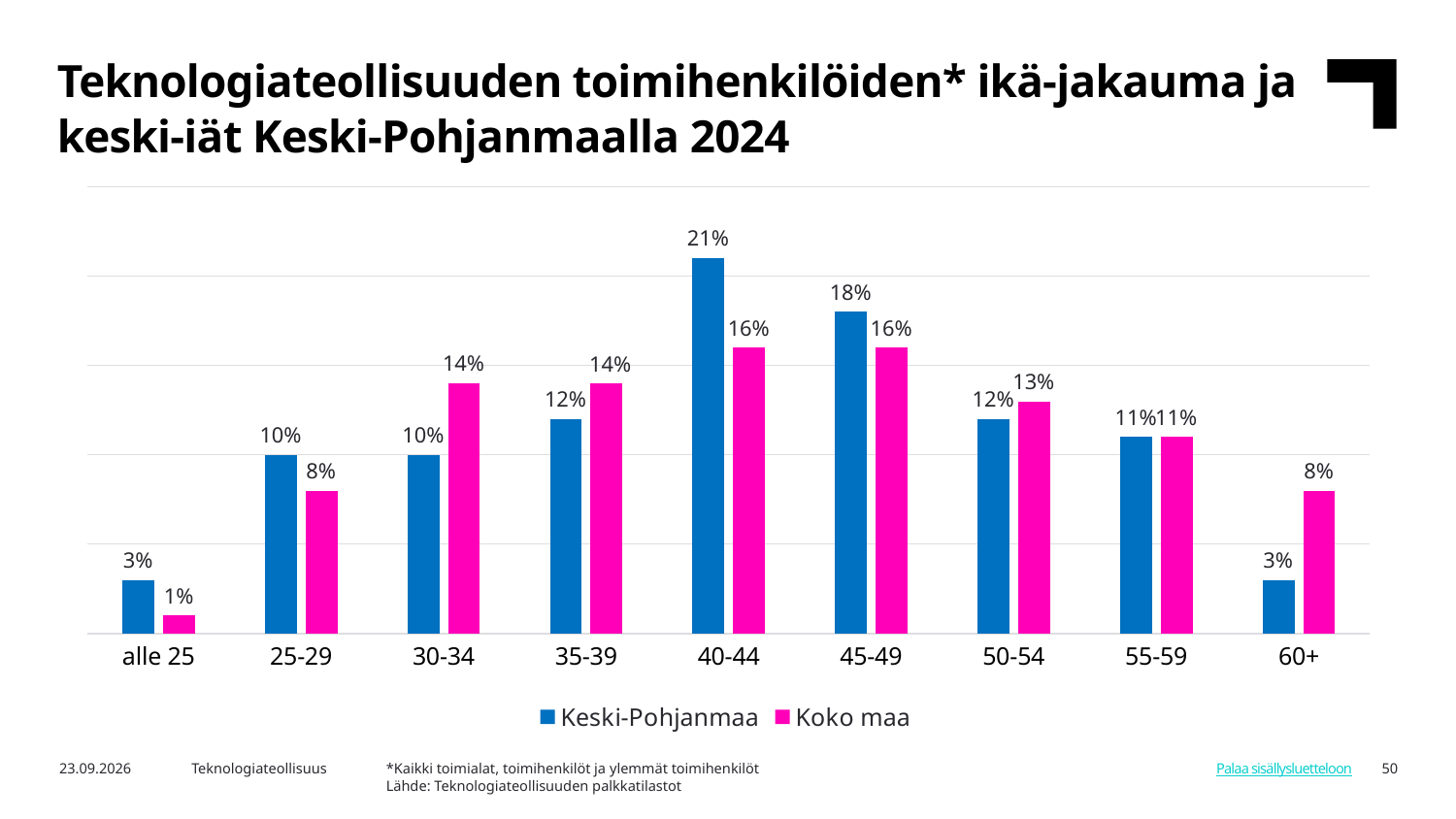
What is the value for Koko maa in the 60+ age group? 8% Which series is shown in magenta in the legend? Koko maa What is the value for Koko maa in the alle 25 age group? 1% How many age groups are shown on the x axis? 9 Which age group has the highest value for Keski-Pohjanmaa? 40-44 How many series does the legend list? 2 What kind of chart is shown on the slide? Bar chart Which age group has the lowest value for Koko maa? alle 25 What is the difference between Keski-Pohjanmaa and Koko maa in the 40-44 age group? 5 percentage points What is the value for Keski-Pohjanmaa in the 40-44 age group? 21% Which is larger in the 45-49 age group, Keski-Pohjanmaa or Koko maa? Keski-Pohjanmaa Which is larger in the 30-34 age group, Keski-Pohjanmaa or Koko maa? Koko maa